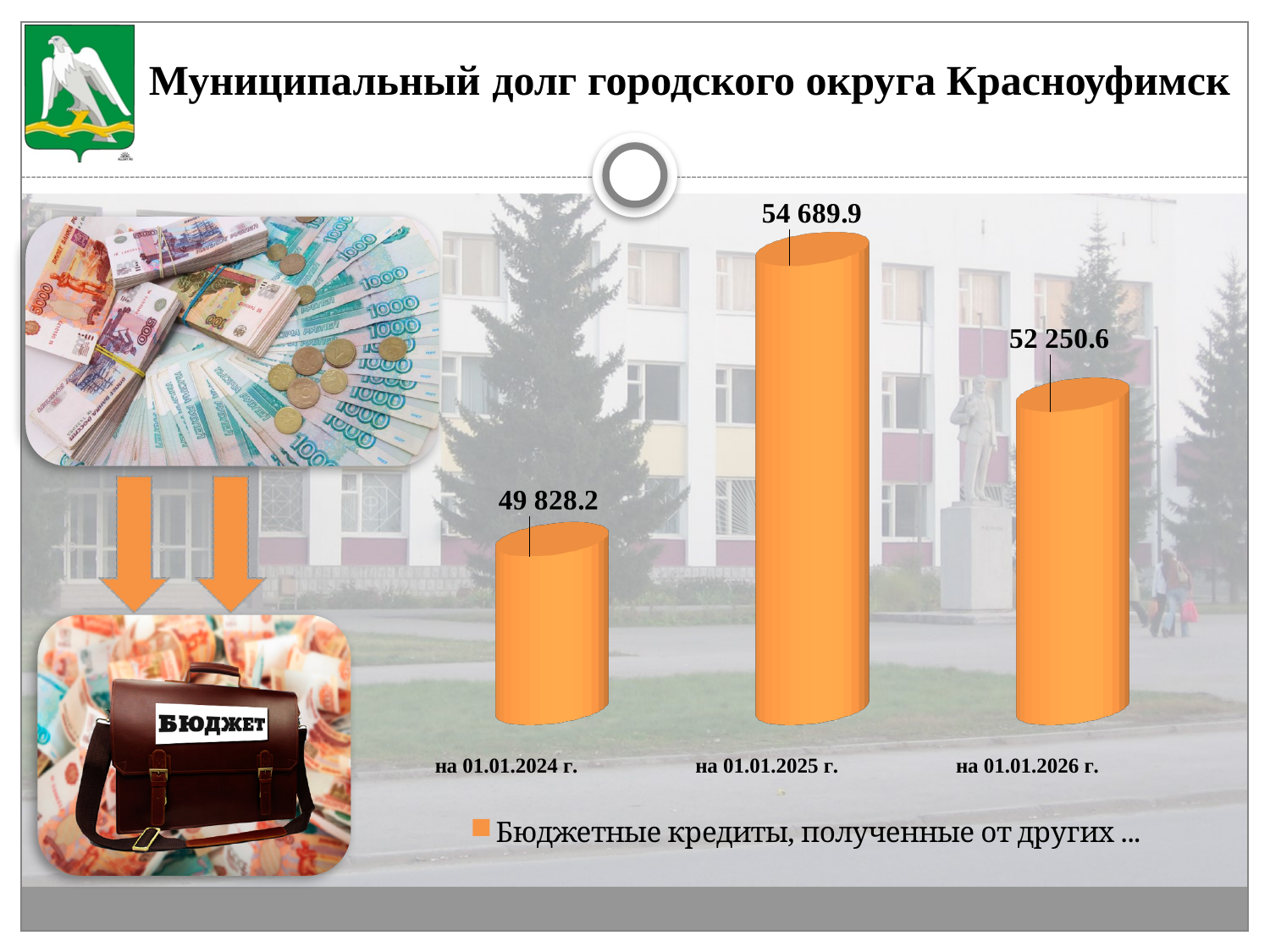
How many series does the legend list? 1 Which date has the lowest value? на 01.01.2024 г. What is the difference between the values for на 01.01.2025 г. and на 01.01.2024 г.? 4 861.7 What is the value shown for на 01.01.2024 г.? 49 828.2 What kind of chart is shown on the slide? bar chart What is the difference between the values for на 01.01.2025 г. and на 01.01.2026 г.? 2 439.3 How many dates are shown on the chart? 3 What is the value shown for на 01.01.2026 г.? 52 250.6 What is the value shown for на 01.01.2025 г.? 54 689.9 Do the values rise or fall from на 01.01.2025 г. to на 01.01.2026 г.? fall Which date has the highest value? на 01.01.2025 г. Which is larger, the value for на 01.01.2026 г. or the value for на 01.01.2024 г.? на 01.01.2026 г.